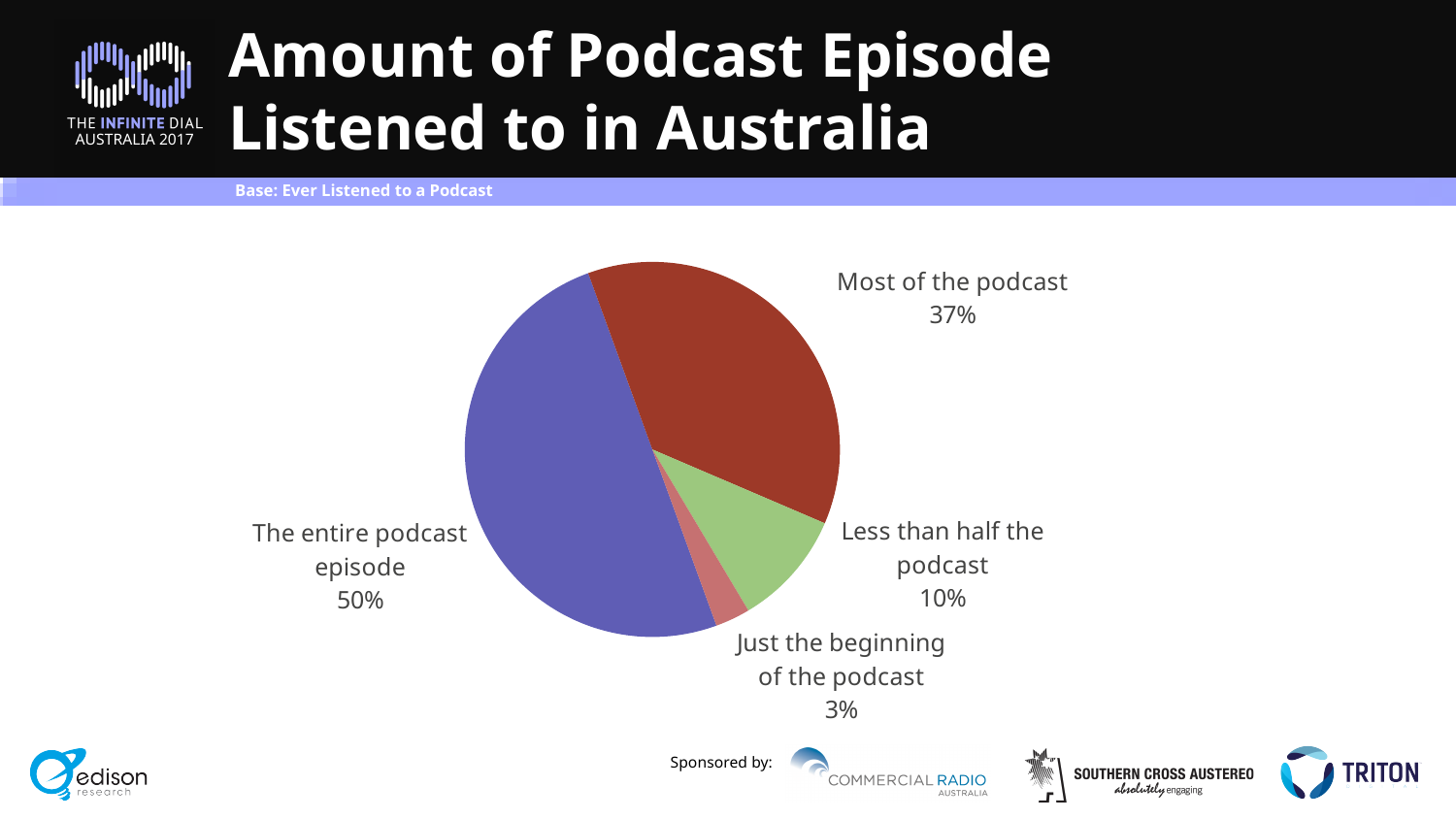
Which category has the smallest share of the pie? Just the beginning of the podcast What percentage of listeners listened to less than half the podcast? 10% What percentage of listeners listened to just the beginning of the podcast? 3% Which is larger: 'Less than half the podcast' or 'Just the beginning of the podcast'? Less than half the podcast What percentage of listeners listened to the entire podcast episode? 50% How many categories are shown in the pie chart? 4 What percentage of listeners listened to most of the podcast? 37% What colour is the slice for 'Most of the podcast'? Red What is the difference in percentage points between 'The entire podcast episode' and 'Most of the podcast'? 13 What kind of chart is shown on the slide? Pie chart What is the title of the chart? Amount of Podcast Episode Listened to in Australia Which category has the largest share of the pie? The entire podcast episode